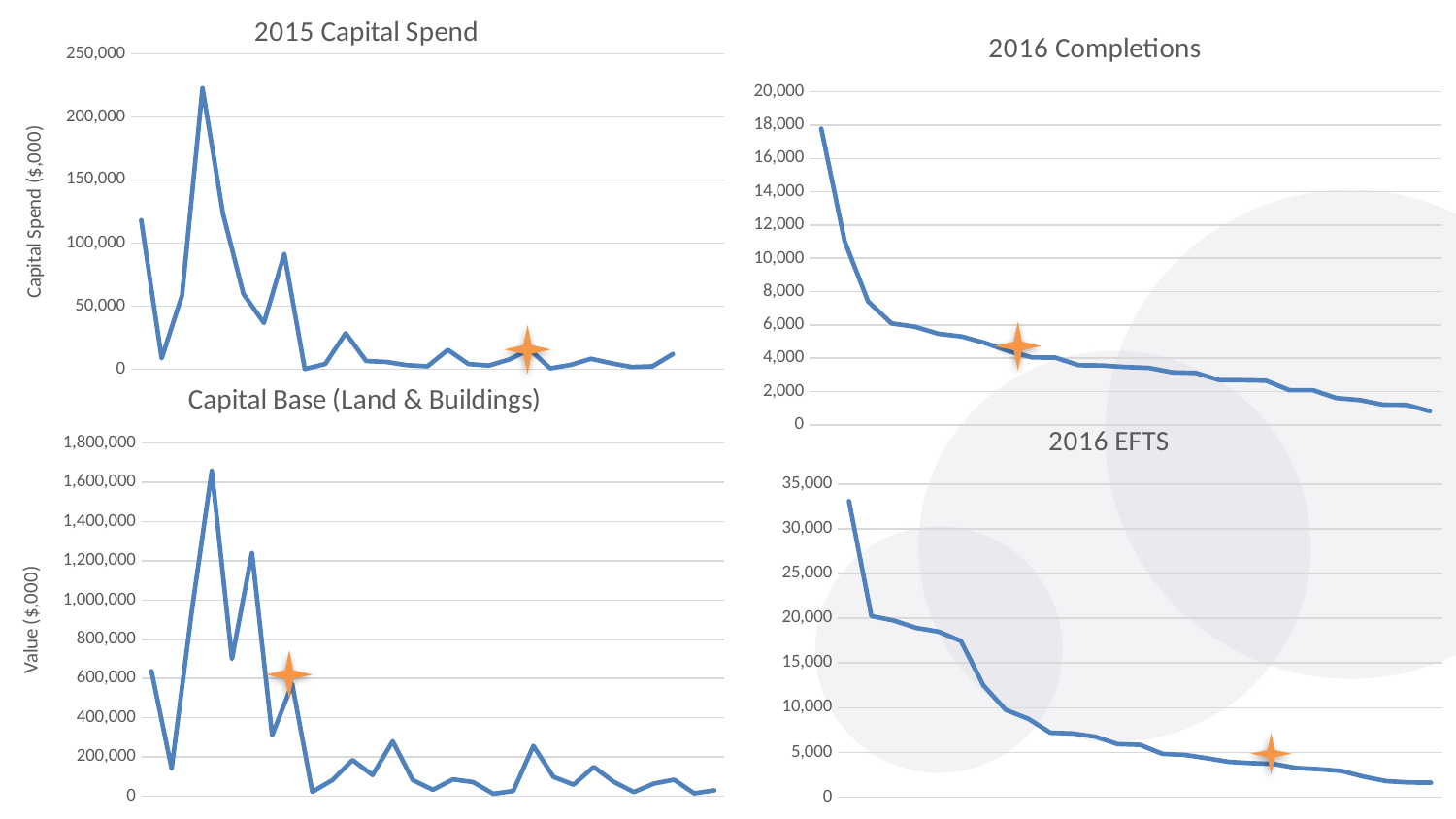
What kind of chart is the "2016 EFTS" chart? line chart In the "2016 Completions" chart, do the values generally rise or fall along the x axis? fall In the "2016 Completions" chart, is the first point on the line greater or less than 16,000? greater What is the y-axis title of the "2015 Capital Spend" chart? Capital Spend ($,000) In the "Capital Base (Land & Buildings)" chart, is the highest point on the line greater or less than 1,600,000? greater In the "2016 EFTS" chart, is the first point on the line greater or less than 30,000? greater What kind of chart is the "2015 Capital Spend" chart? line chart In the "2016 EFTS" chart, do the values generally rise or fall along the x axis? fall How many charts are shown on the slide? 4